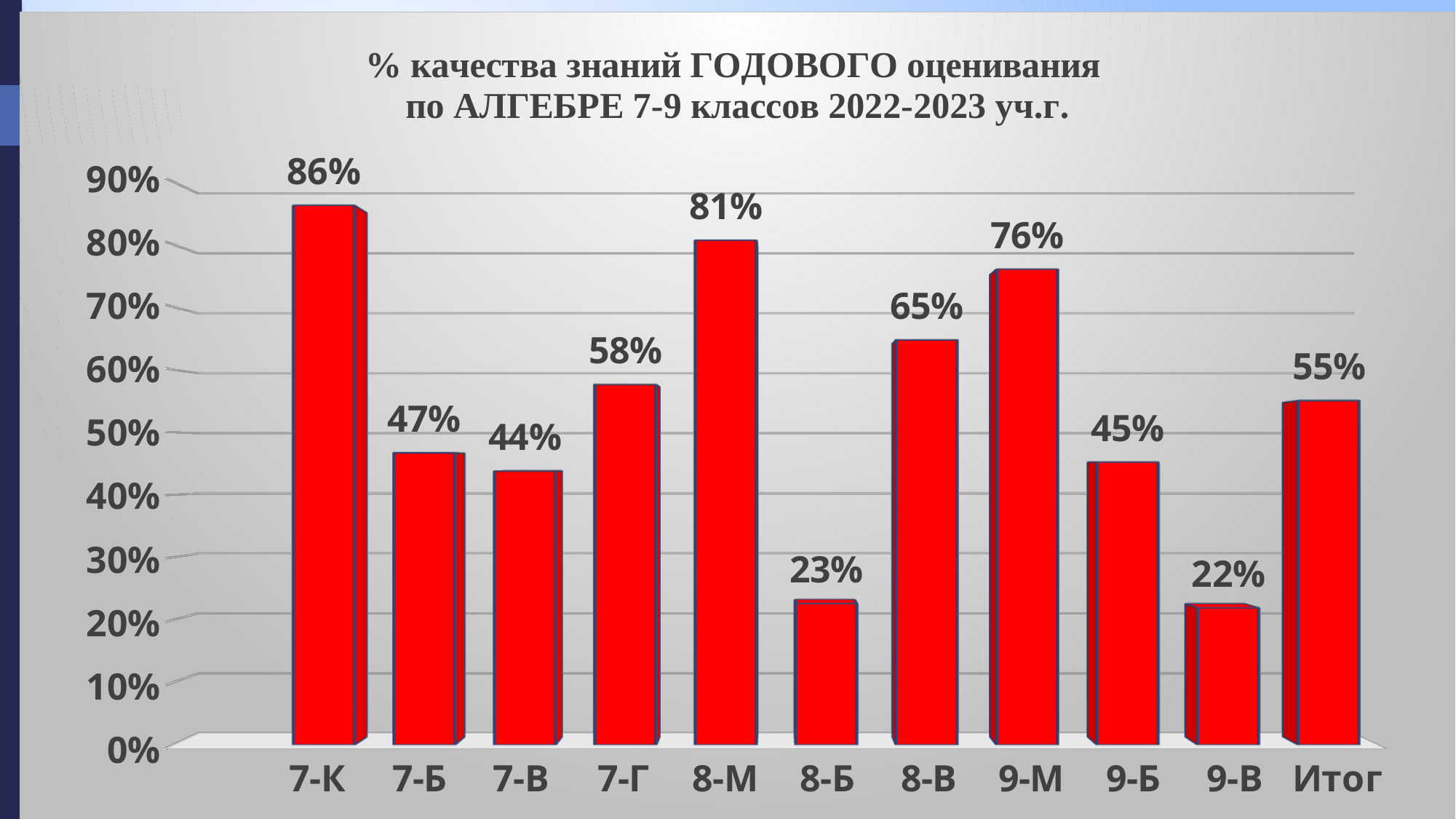
What is the value for 8-Б? 23% Which category has the lowest value? 9-В What colour are the bars? red Which is larger, the value for 7-Г or the value for 8-В? 8-В What is the difference between the values for 8-М and 8-Б? 58% What is the value for 7-К? 86% Is the value for 9-М greater or less than 70%? greater What kind of chart is this? bar chart How many categories are shown on the x axis? 11 What is the value for Итог? 55% Which category has the highest value? 7-К What is the difference between the values for 7-Б and 7-В? 3%